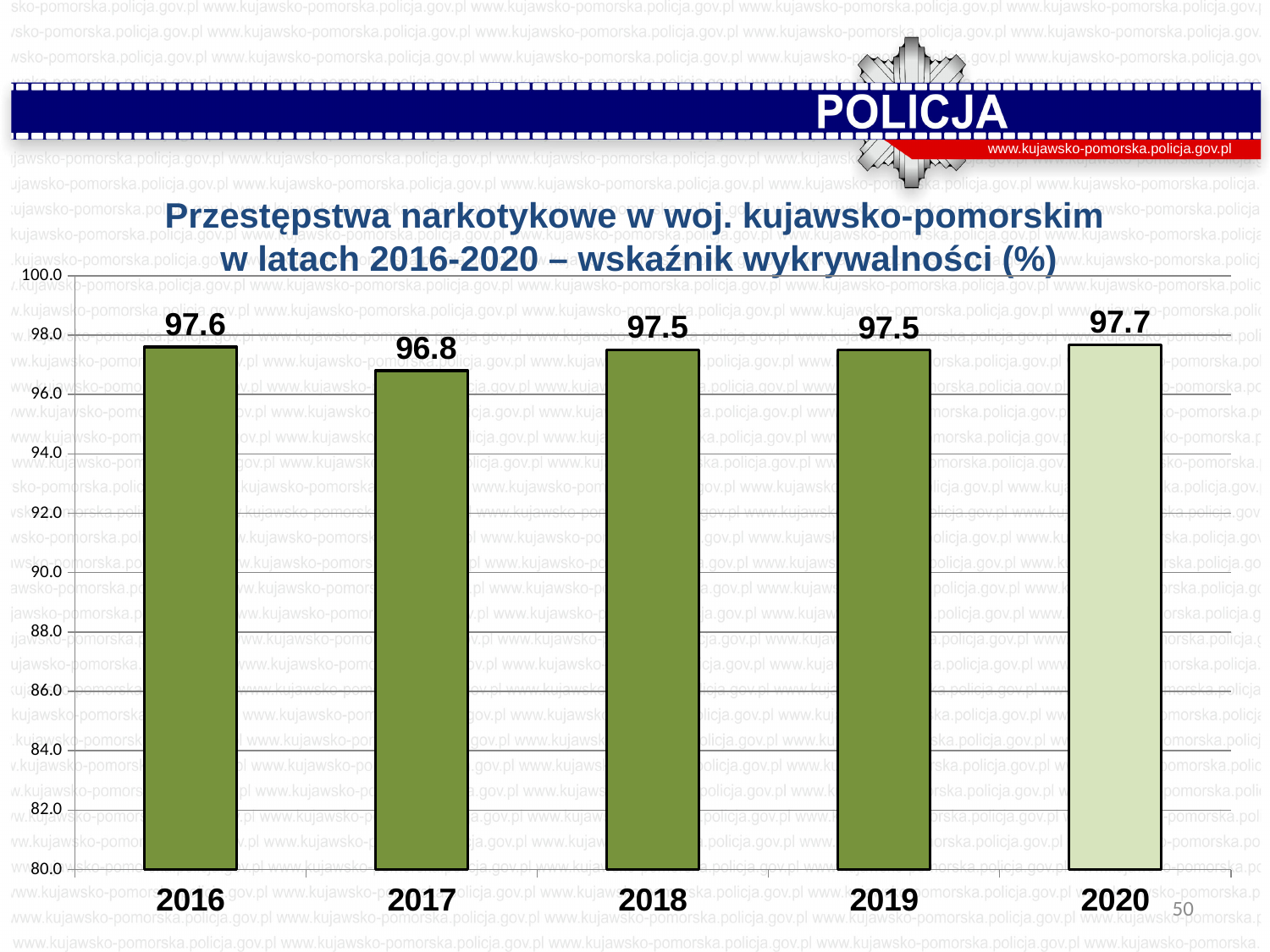
What is the value shown for 2017? 96.8 Which year has the lowest value? 2017 Which bar is shown in a lighter colour than the others? 2020 How many years are shown on the x axis? 5 What kind of chart is this? bar chart What is the value shown for 2020? 97.7 Which year has the highest value? 2020 What is the detection rate value shown for 2016? 97.6 Which is larger, the value for 2017 or the value for 2019? 2019 Is the value for 2017 greater or less than 98.0? less What is the difference between the values for 2016 and 2017? 0.8 Do the values rise or fall from 2017 to 2018? rise